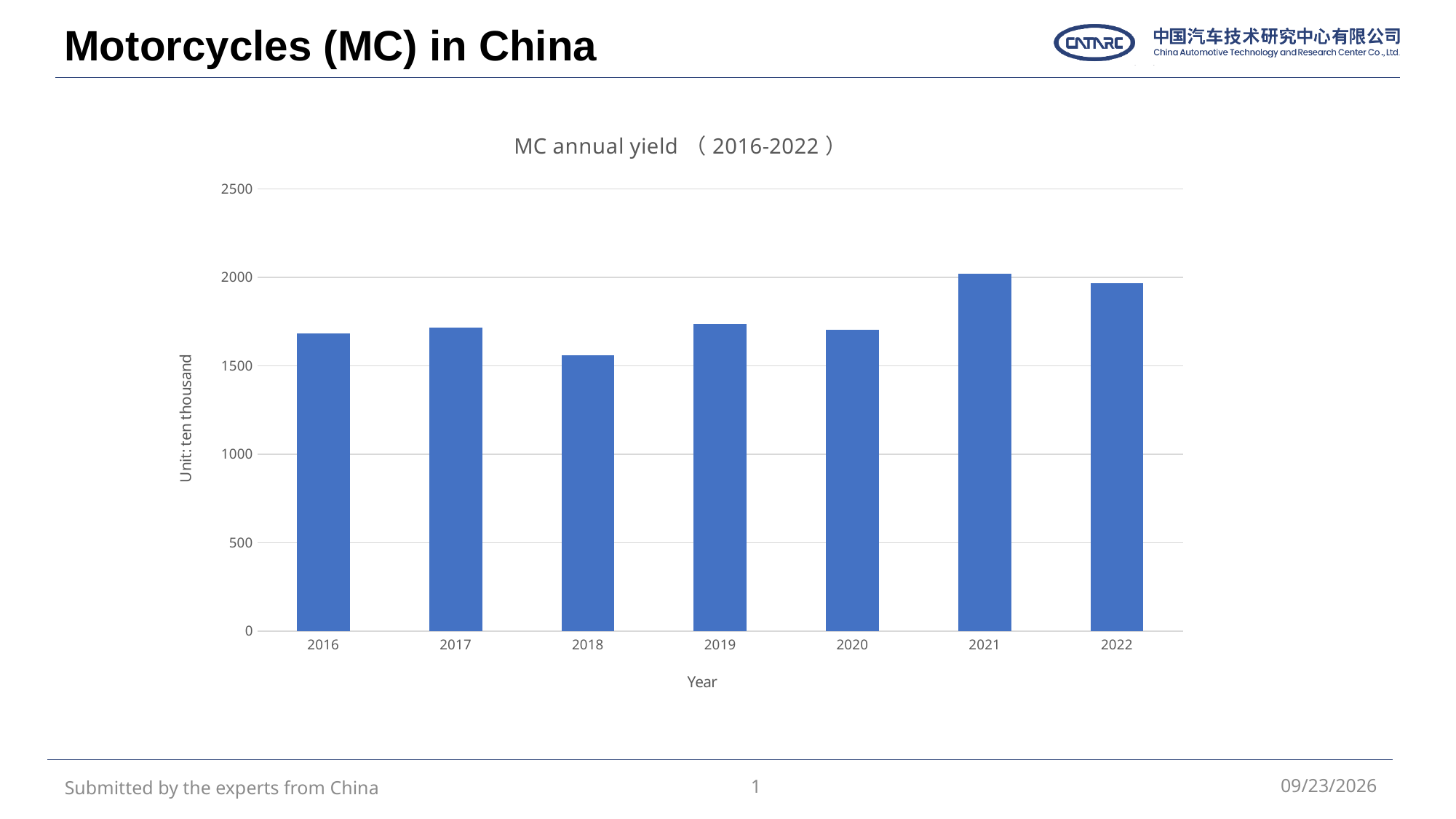
Is the value for 2018 greater or less than 1500? greater Is the value for 2021 greater or less than 2000? greater Which year has the highest MC annual yield? 2021 Do the values rise or fall from 2018 to 2021? rise Is the value for 2019 greater or less than 2000? less What unit is given on the vertical axis of the chart? ten thousand What kind of chart is shown on the slide? bar chart Which year has the larger MC annual yield, 2021 or 2016? 2021 Which year has the lowest MC annual yield? 2018 Which year has the larger MC annual yield, 2018 or 2019? 2019 How many years are plotted in the MC annual yield chart? 7